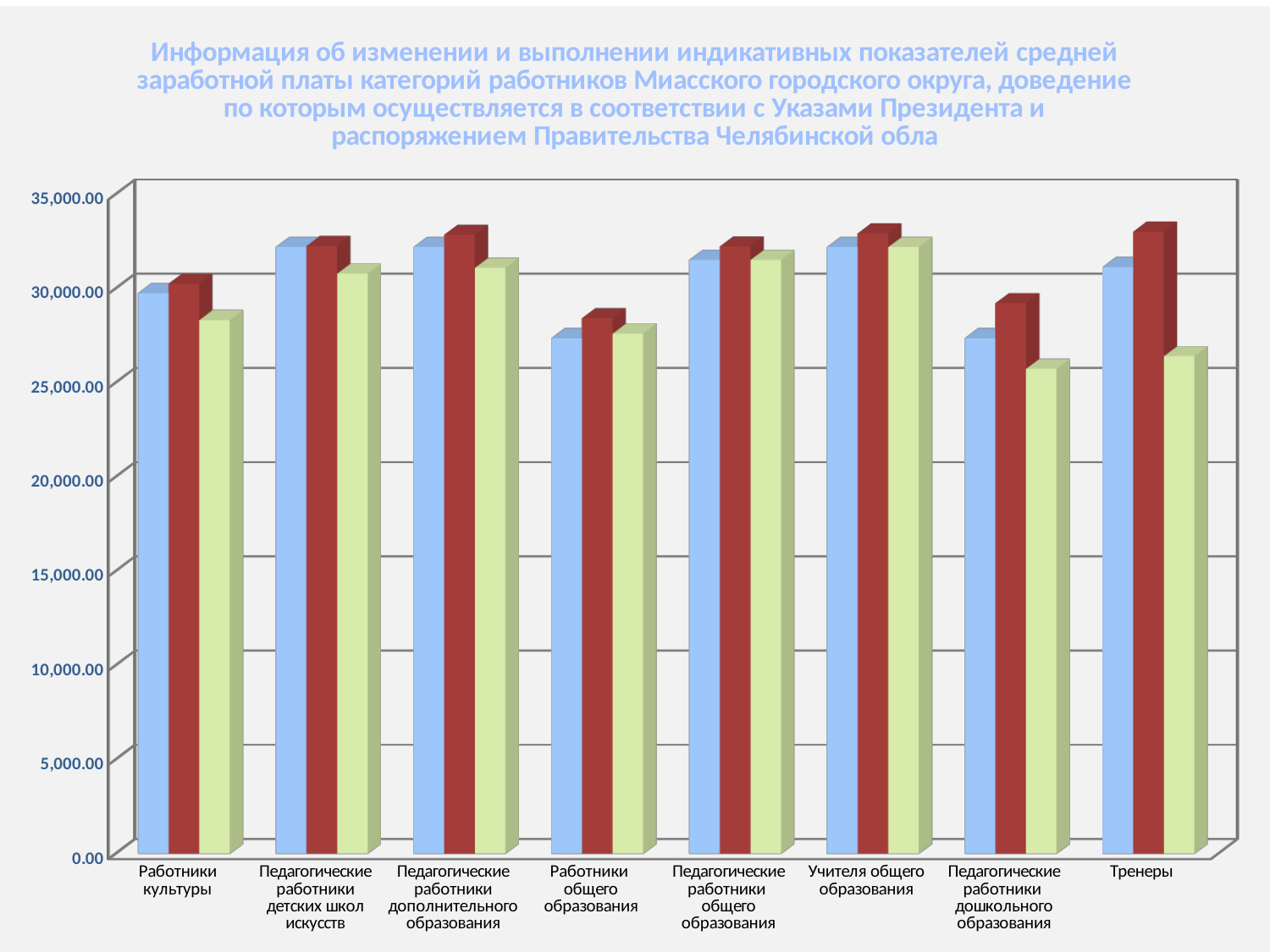
Is the value of the blue bar for Педагогические работники детских школ искусств greater or less than 30,000.00? greater For Педагогические работники дошкольного образования, which is larger: the red bar or the green bar? the red bar What three colours are used for the bars in the chart? blue, red and green Is the value of the red bar for Тренеры greater or less than 30,000.00? greater For Тренеры, which is larger: the red bar or the green bar? the red bar How many categories are shown along the x axis of the chart? 8 What is the highest value shown on the vertical axis of the chart? 35,000.00 Is the value of the blue bar for Работники общего образования greater or less than 30,000.00? less What kind of chart is shown on the slide? bar chart How many bars are plotted for each category in the chart? 3